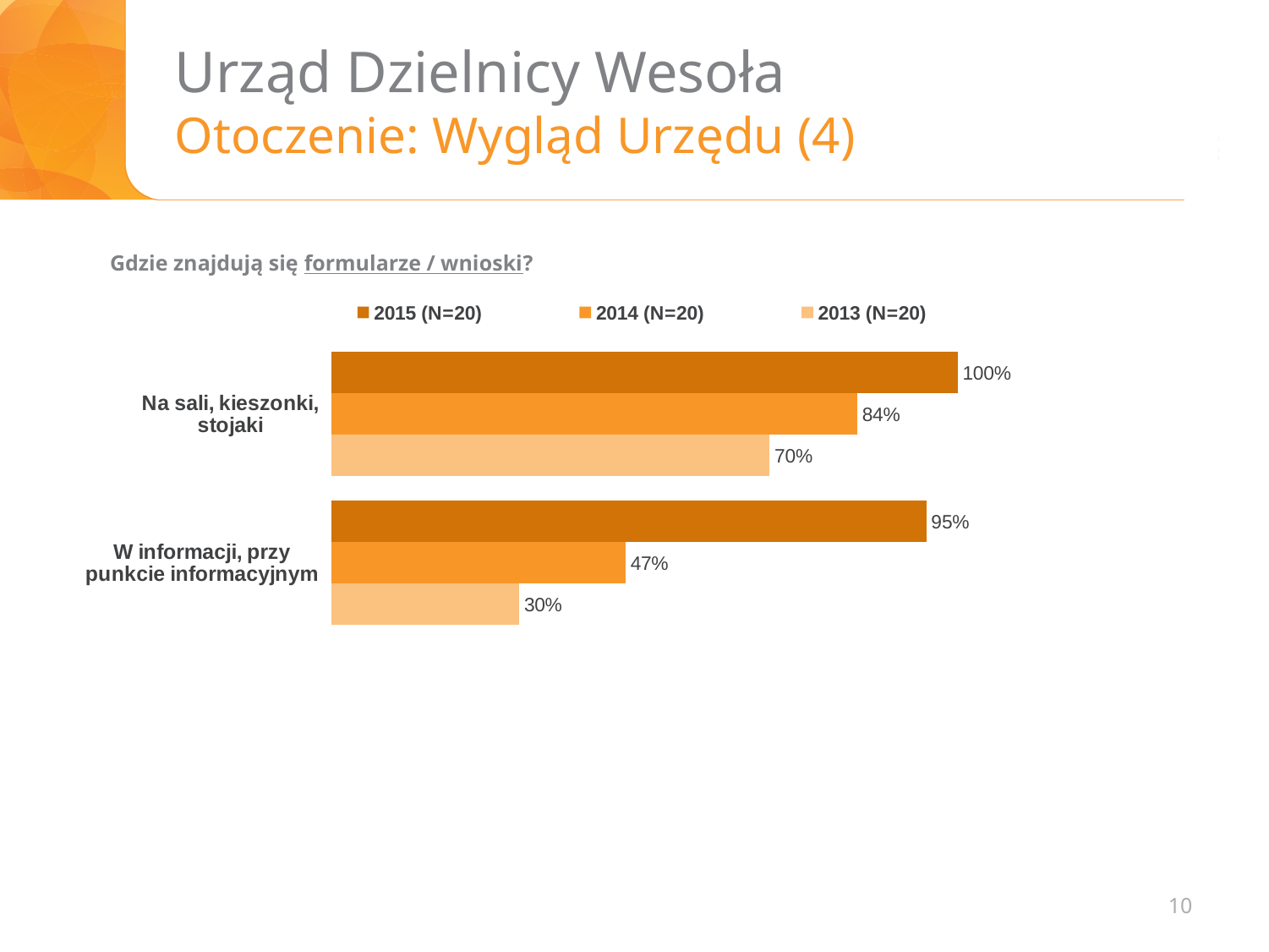
What is the value for "Na sali, kieszonki, stojaki" in the 2015 (N=20) series? 100% What is the difference between the 2015 (N=20) and 2014 (N=20) values for "W informacji, przy punkcie informacyjnym"? 48% How many categories are shown on the chart? 2 How many series does the legend list? 3 What is the value for "Na sali, kieszonki, stojaki" in the 2013 (N=20) series? 70% What kind of chart is shown on the slide? Bar chart Which is larger: the 2013 (N=20) value for "Na sali, kieszonki, stojaki" or the 2014 (N=20) value for "W informacji, przy punkcie informacyjnym"? 2013 (N=20) value for "Na sali, kieszonki, stojaki" Which series has the highest value for "W informacji, przy punkcie informacyjnym"? 2015 (N=20) What is the difference between the 2014 (N=20) and 2013 (N=20) values for "Na sali, kieszonki, stojaki"? 14% Which category has the lowest value in the 2014 (N=20) series? W informacji, przy punkcie informacyjnym What is the value for "W informacji, przy punkcie informacyjnym" in the 2013 (N=20) series? 30% What is the value for "W informacji, przy punkcie informacyjnym" in the 2014 (N=20) series? 47%